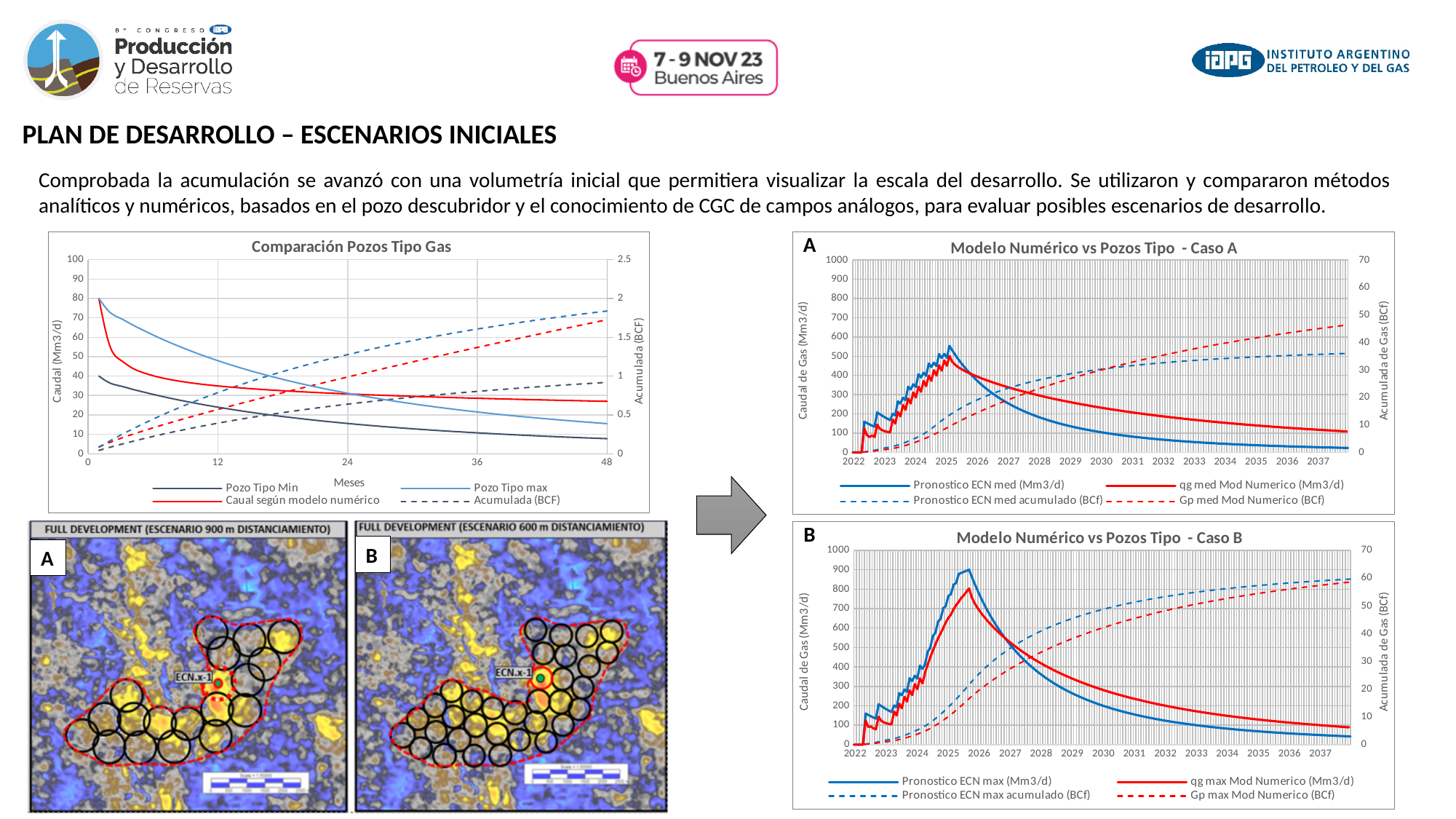
In the 'Modelo Numérico vs Pozos Tipo - Caso A' chart, is the peak value of 'Pronostico ECN med (Mm3/d)' greater or less than 400? greater In the 'Comparación Pozos Tipo Gas' chart, is the value of 'Pozo Tipo Min' at month 48 greater or less than 20? less In the 'Modelo Numérico vs Pozos Tipo - Caso A' chart, which accumulated series is higher at 2037: 'Pronostico ECN med acumulado (BCf)' or 'Gp med Mod Numerico (BCf)'? Gp med Mod Numerico (BCf) How many series does the legend of the 'Comparación Pozos Tipo Gas' chart list? 4 What kind of chart is the 'Comparación Pozos Tipo Gas' chart? line chart In the 'Comparación Pozos Tipo Gas' chart, is the starting value of 'Pozo Tipo max' greater or less than 60? greater In the 'Comparación Pozos Tipo Gas' chart, does the 'Pozo Tipo max' series rise or fall along the x axis? fall In the 'Comparación Pozos Tipo Gas' chart, what is the label of the x axis? Meses How many series does the legend of the 'Modelo Numérico vs Pozos Tipo - Caso A' chart list? 4 In the 'Comparación Pozos Tipo Gas' chart, does the 'Acumulada (BCF)' series rise or fall along the x axis? rise Which chart shows a higher peak gas rate: 'Modelo Numérico vs Pozos Tipo - Caso A' or 'Modelo Numérico vs Pozos Tipo - Caso B'? Caso B